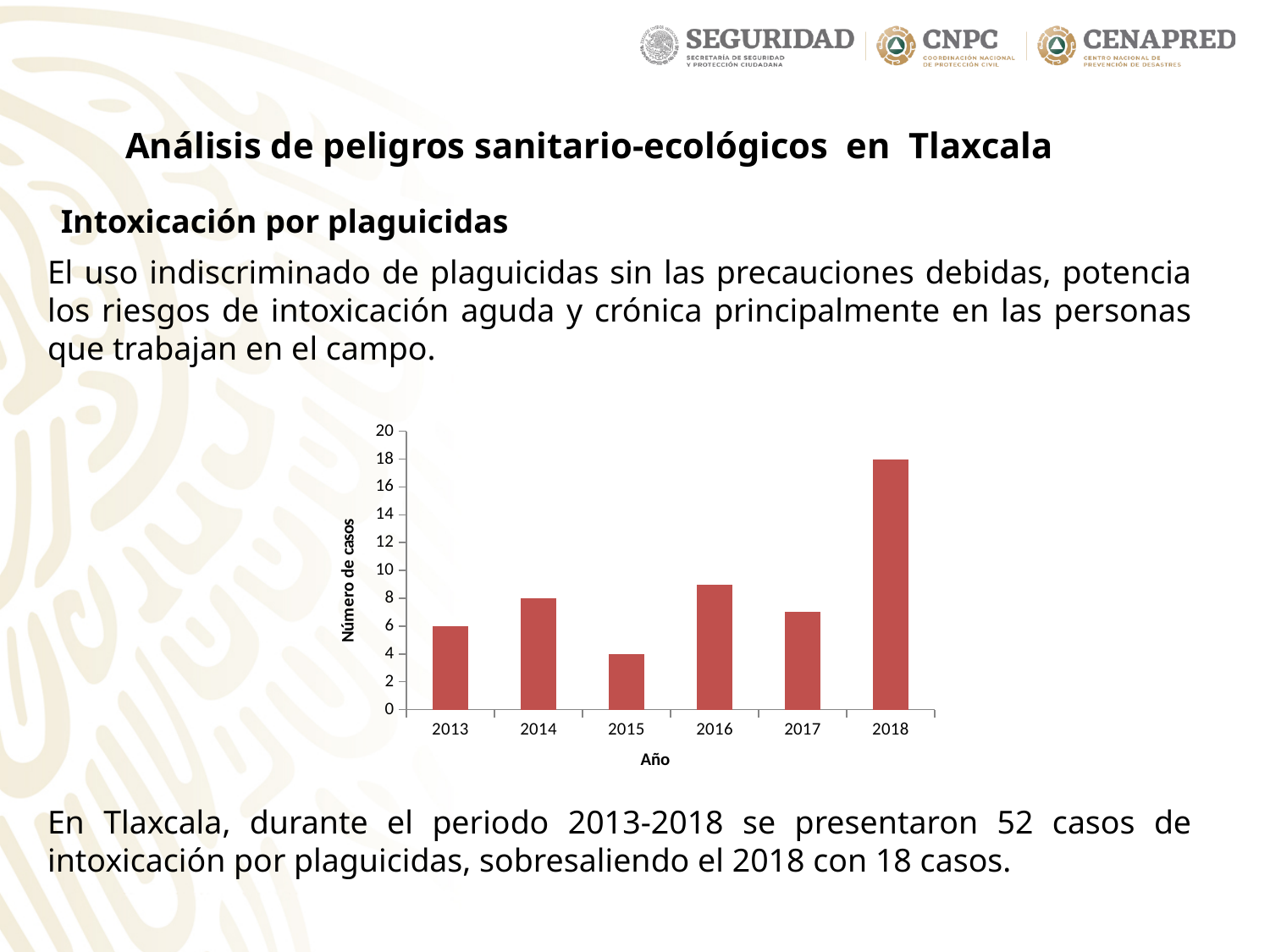
What is the difference in cases between 2018 and 2015? 14 How many cases are shown for 2013? 6 How many cases are shown for 2018? 18 How many cases are shown for 2014? 8 Is the value for 2016 greater or less than 8? greater Is the value for 2017 greater or less than 8? less How many years are shown on the x axis of the chart? 6 Which year has the lowest number of cases? 2015 Which year has the highest number of cases? 2018 Which year has more cases, 2016 or 2017? 2016 What type of chart is shown on the slide? bar chart How many cases are shown for 2015? 4